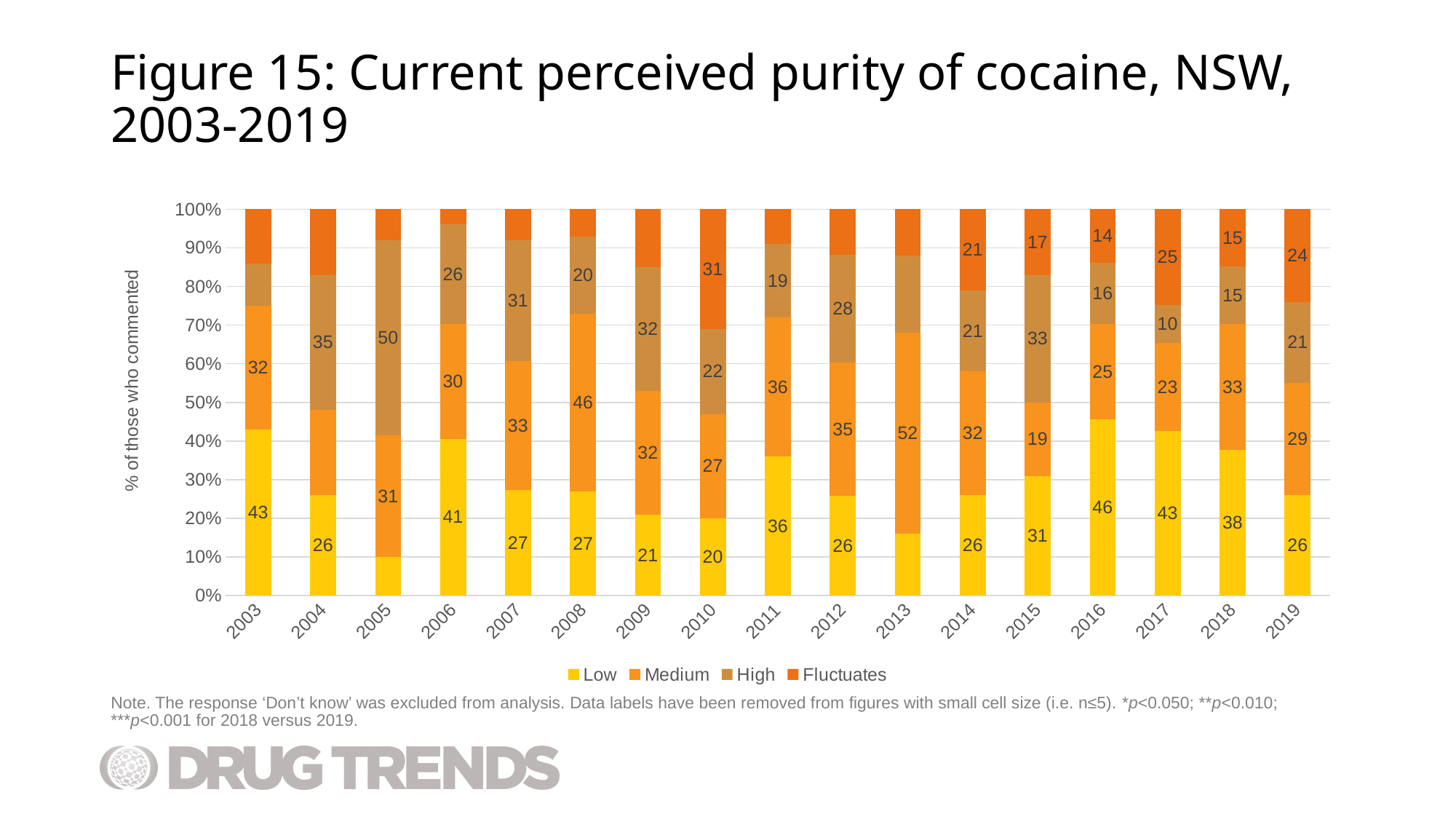
How many years are shown on the x axis? 17 Is the Low value for 2005 greater or less than 20%? less What percentage of those who commented rated cocaine purity as Low in 2016? 46 What is the value for the Medium series in 2013? 52 By how many percentage points did the Low value fall from 2018 to 2019? 12 In which year was the Low segment the largest? 2016 What kind of chart is shown on the slide? Stacked bar chart What is the value for the High series in 2005? 50 What is the value for the Fluctuates series in 2010? 31 In which year was the High segment the largest? 2005 Which year had a larger Medium value, 2008 or 2019? 2008 How many series does the legend list? 4